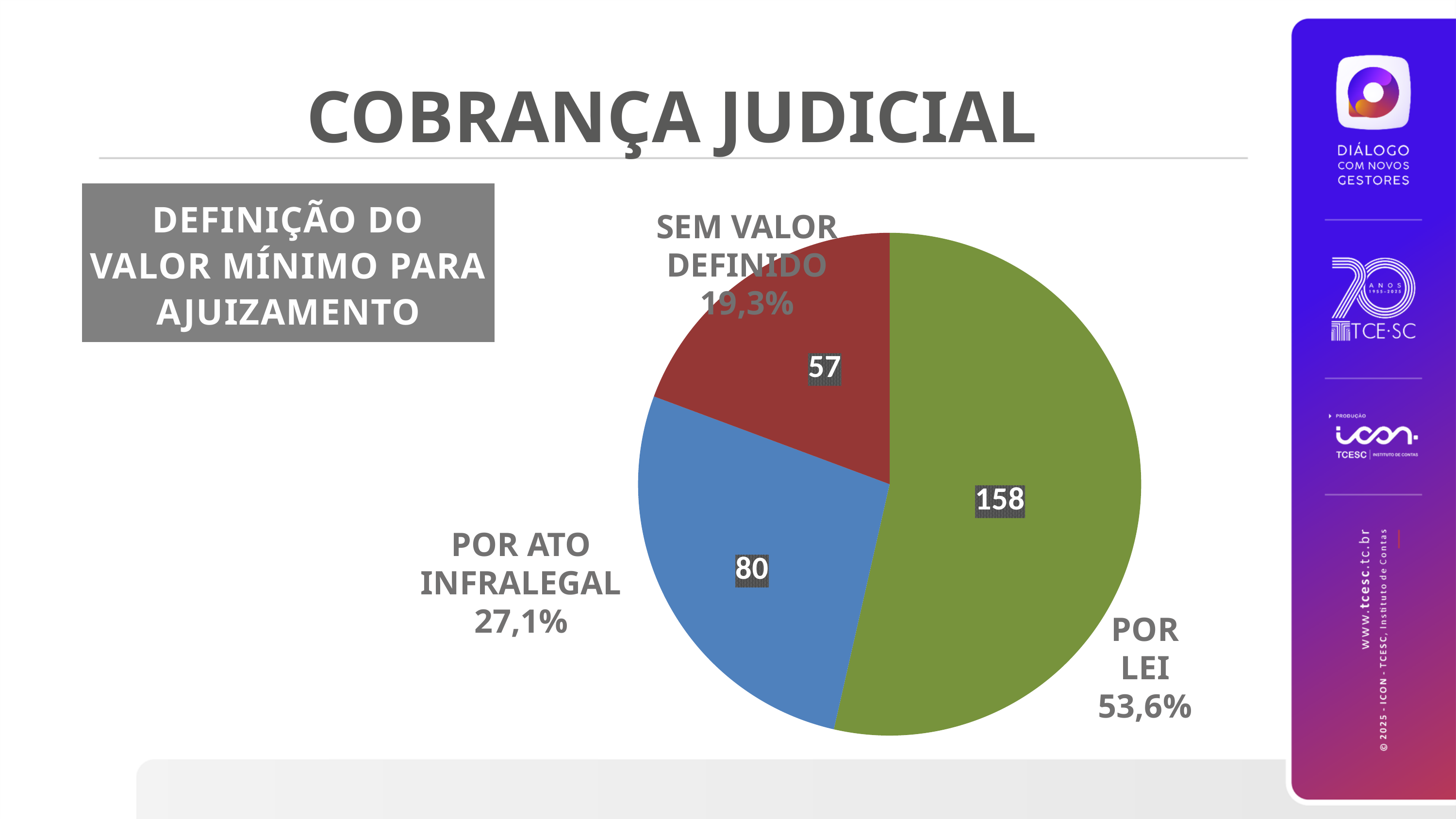
Which is larger, the value for POR ATO INFRALEGAL or SEM VALOR DEFINIDO? POR ATO INFRALEGAL What share of the pie does POR ATO INFRALEGAL represent? 27,1% What share of the pie does SEM VALOR DEFINIDO represent? 19,3% What is the difference between the values for POR LEI and POR ATO INFRALEGAL? 78 What is the value for SEM VALOR DEFINIDO? 57 Which category has the smallest slice? SEM VALOR DEFINIDO How many slices does the pie chart have? 3 What is the value for POR ATO INFRALEGAL? 80 What is the value for POR LEI? 158 Which category has the largest slice? POR LEI What type of chart is shown on the slide? pie chart What share of the pie does POR LEI represent? 53,6%